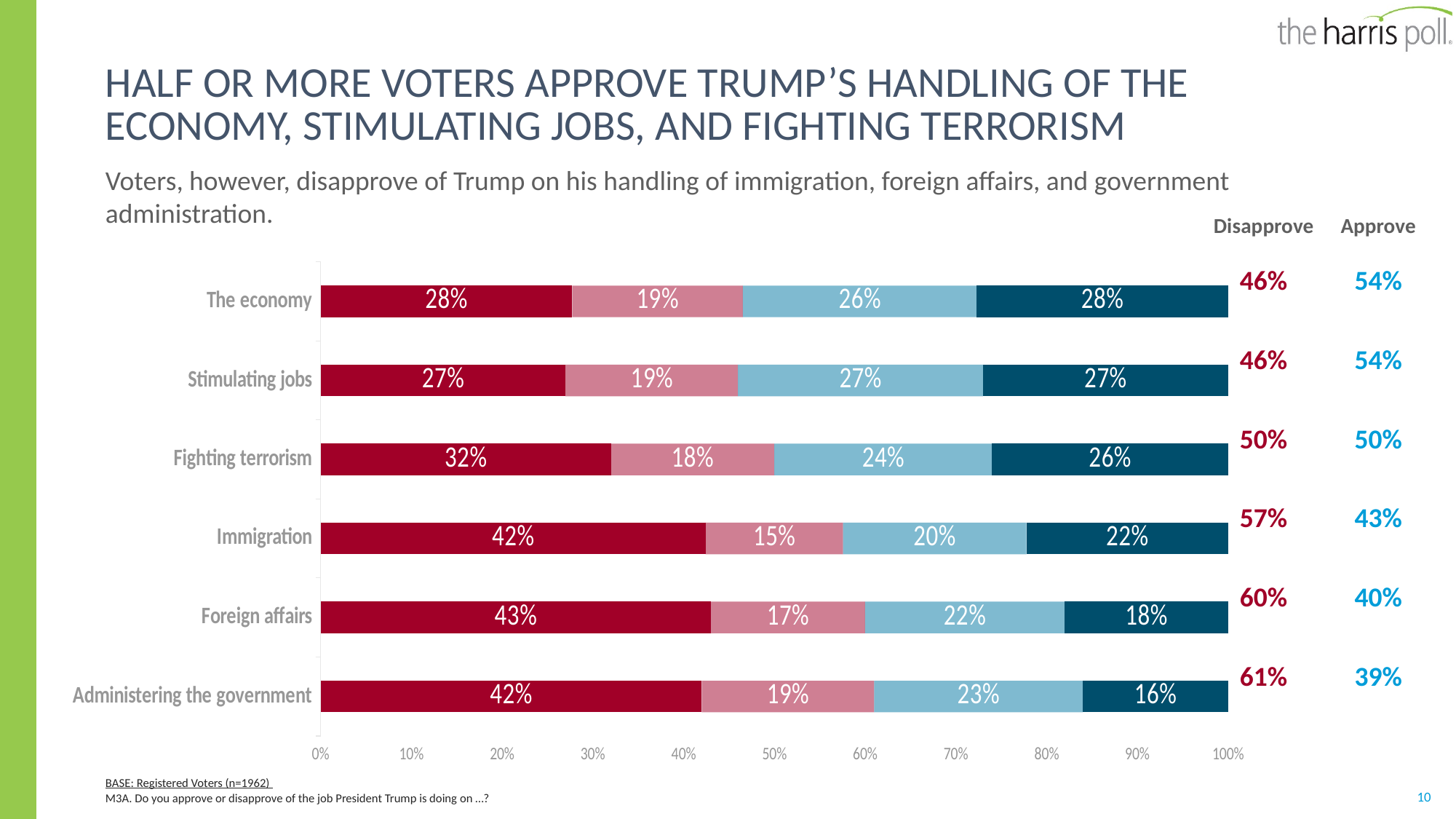
What is the difference between the Disapprove and Approve totals for Immigration? 14% How many categories (issues) are plotted in the chart? 6 What is the value of the first (dark red) segment for Immigration? 42% What is the value of the third (light blue) segment for Administering the government? 23% Which issue has the lowest Approve total? Administering the government Which issue has the highest Disapprove total? Administering the government What is the Disapprove total shown for Foreign affairs? 60% What type of chart is shown on the slide? stacked bar chart What is the Approve total shown for Fighting terrorism? 50% What is the value of the last (dark blue) segment for The economy? 28% Which is larger: the first (dark red) segment for Foreign affairs or for Fighting terrorism? Foreign affairs What is the total of the four segments for Stimulating jobs? 100%